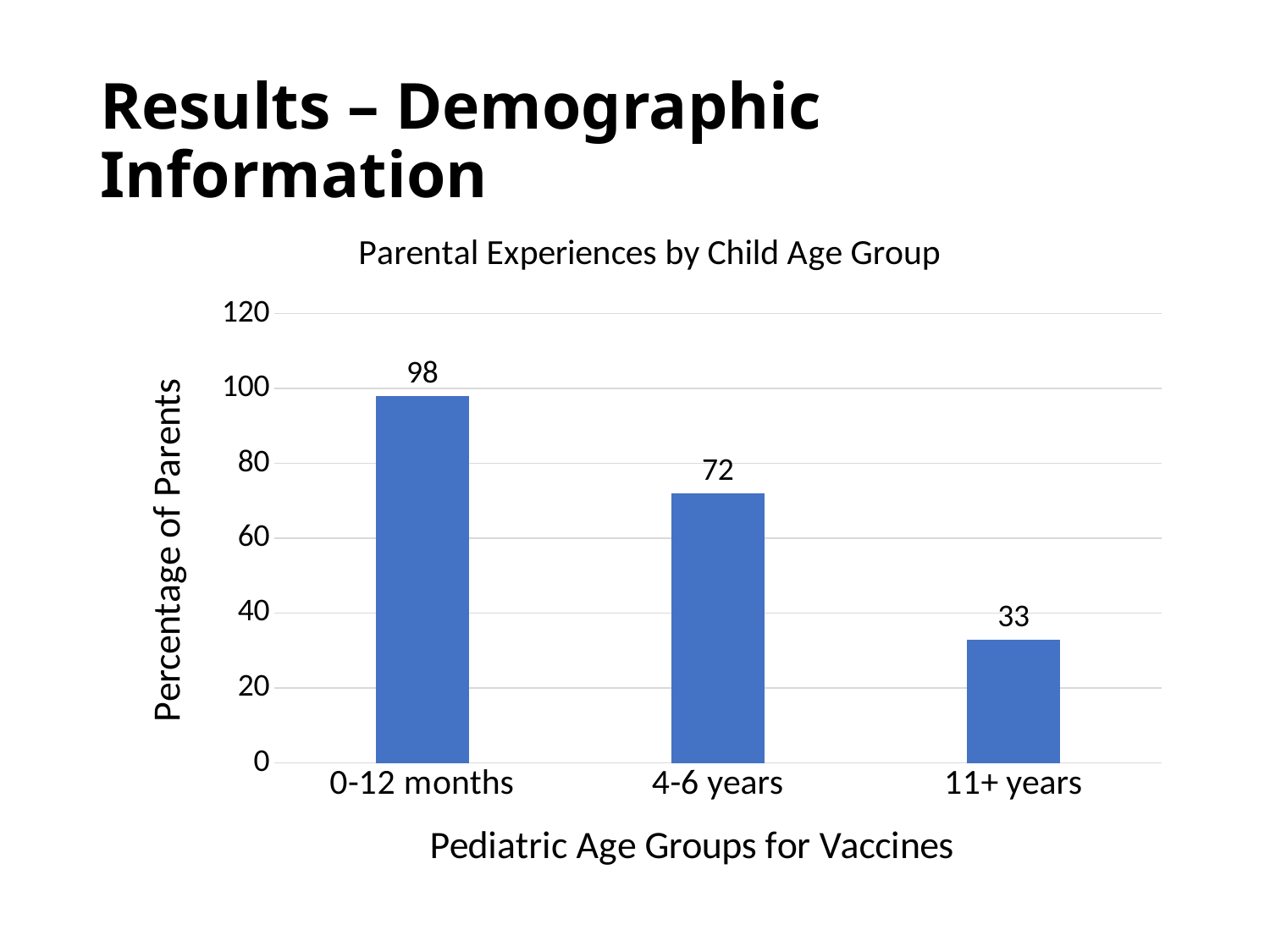
Which age group has the highest percentage of parents? 0-12 months What is the value for 11+ years? 33 What is the difference between the values for 4-6 years and 11+ years? 39 Which is larger, the value for 4-6 years or the value for 11+ years? 4-6 years What is the value for 0-12 months? 98 Is the value for 11+ years greater or less than 40? less Which age group has the lowest percentage of parents? 11+ years What kind of chart is shown on the slide? bar chart What is the difference between the values for 0-12 months and 4-6 years? 26 How many age groups are shown in the chart? 3 What is the title of the chart? Parental Experiences by Child Age Group What is the value for 4-6 years? 72